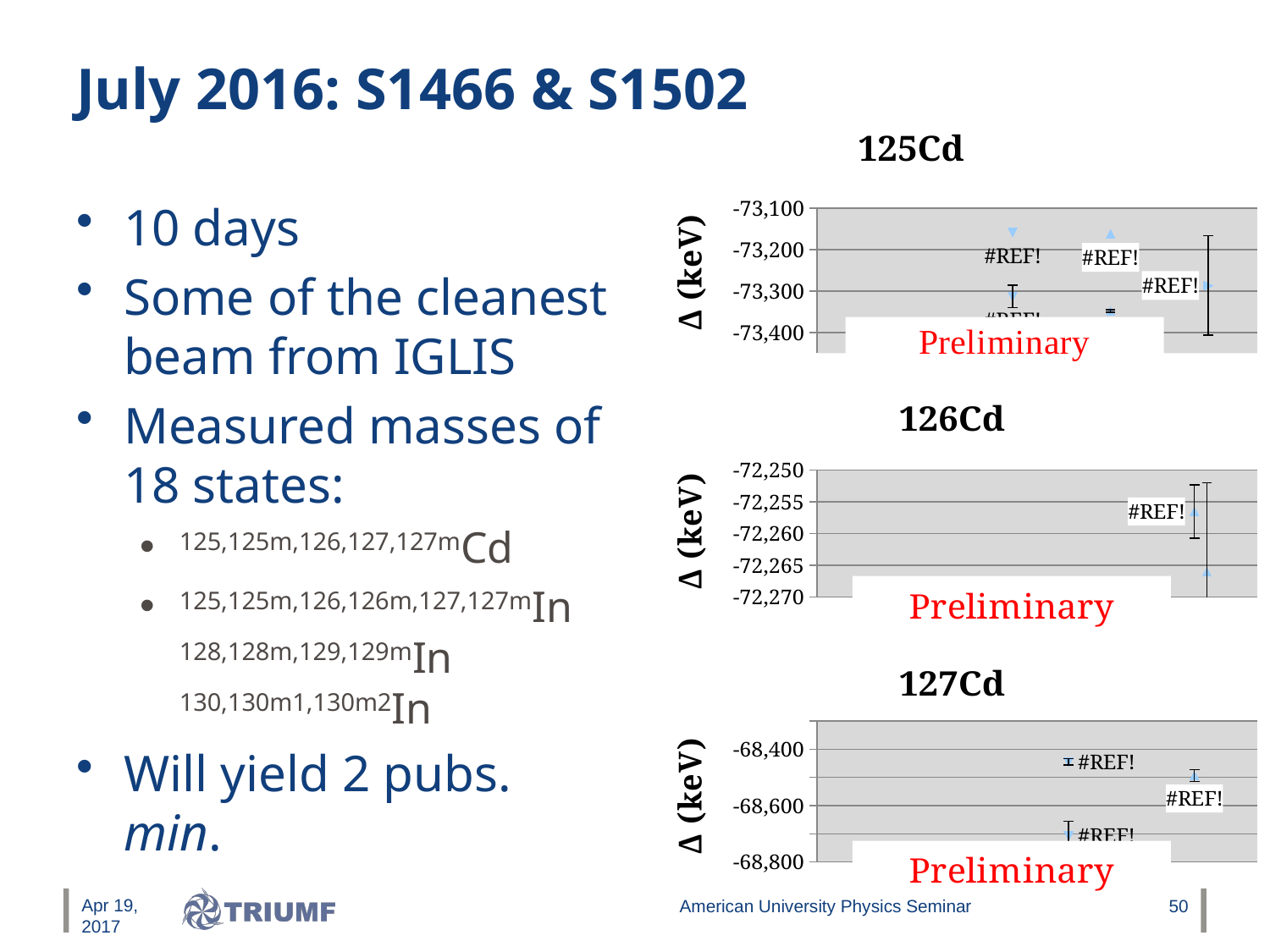
In the 127Cd chart, is the value of the rightmost data point greater or less than -68,400? less What is the y-axis label of the 126Cd chart? Δ (keV) In the 127Cd chart, is the value of the rightmost data point greater or less than -68,600? greater How many charts are shown on the slide? 3 In the 125Cd chart, is the value of the rightmost data point greater or less than -73,200? less What is the title of the top chart on the right side of the slide? 125Cd What type of chart is the 125Cd chart? scatter chart